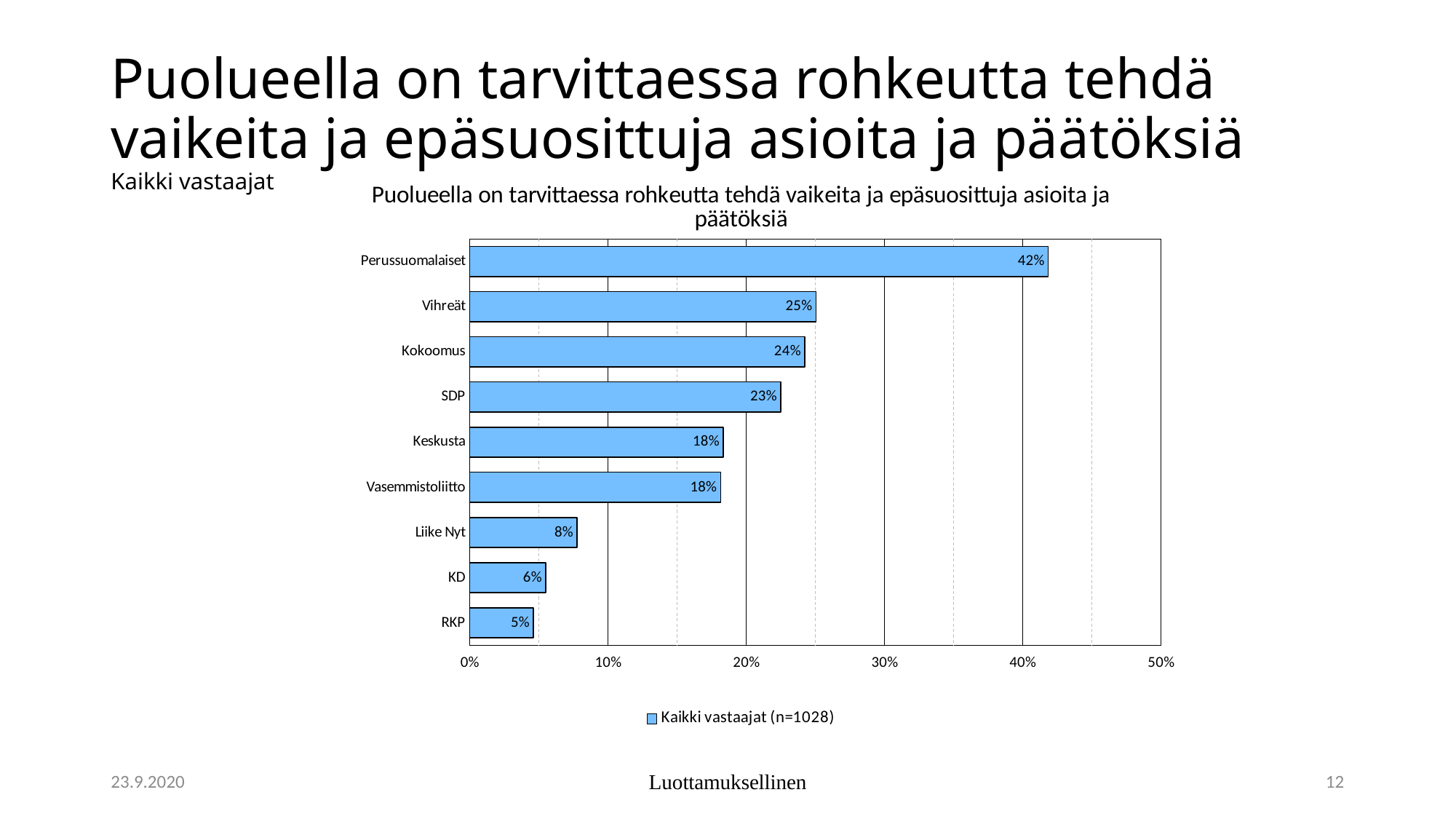
What is the value for Liike Nyt? 8% Which is larger, the value for Vihreät or the value for Keskusta? Vihreät How many parties are shown in the chart? 9 Which party has the highest value? Perussuomalaiset What is the difference between the values for Kokoomus and KD? 18% Which party has the lowest value? RKP What is the value for Perussuomalaiset? 42% Is the value for Kokoomus greater or less than 20%? greater What is the difference between the values for Perussuomalaiset and Vihreät? 17% What kind of chart is shown on the slide? bar chart What is the legend entry of the chart? Kaikki vastaajat (n=1028) What is the value for SDP? 23%